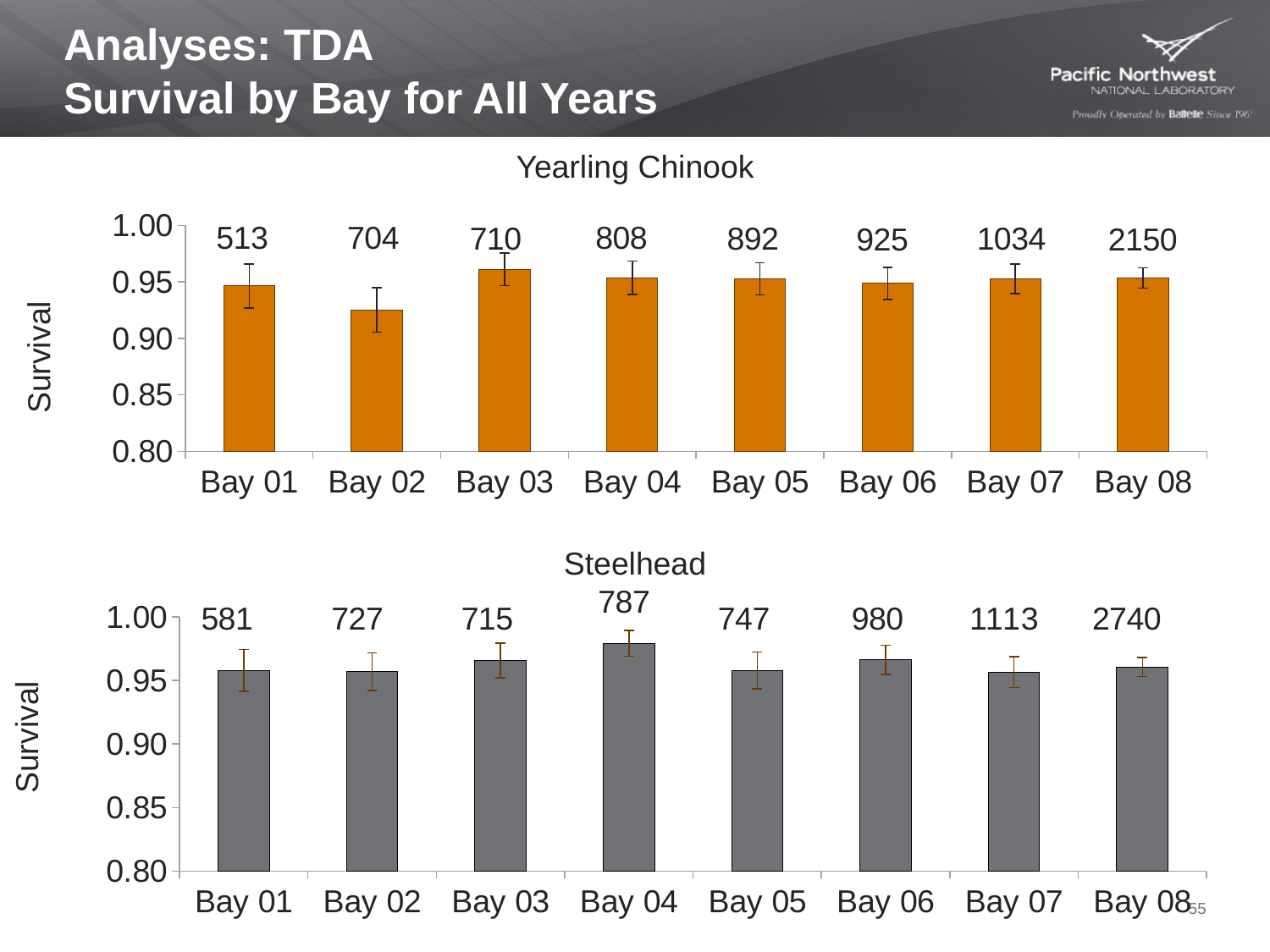
In the Steelhead chart, which bay has the highest survival? Bay 04 How many bays are shown on the x axis of the Steelhead chart? 8 In the Yearling Chinook chart, is the survival value for Bay 03 greater or less than 0.95? greater What type of chart is the Yearling Chinook chart? bar chart In the Yearling Chinook chart, which bay has the lowest survival? Bay 02 In the Yearling Chinook chart, which bay has the highest survival? Bay 03 In the Yearling Chinook chart, what number is printed above the Bay 08 bar? 2150 In the Steelhead chart, what number is printed above the Bay 06 bar? 980 In the Yearling Chinook chart, is the survival value for Bay 02 greater or less than 0.95? less What is the label on the y axis of the Steelhead chart? Survival In the Steelhead chart, is the survival value for Bay 04 greater or less than 0.95? greater In the Yearling Chinook chart, which bay has the larger survival, Bay 02 or Bay 03? Bay 03